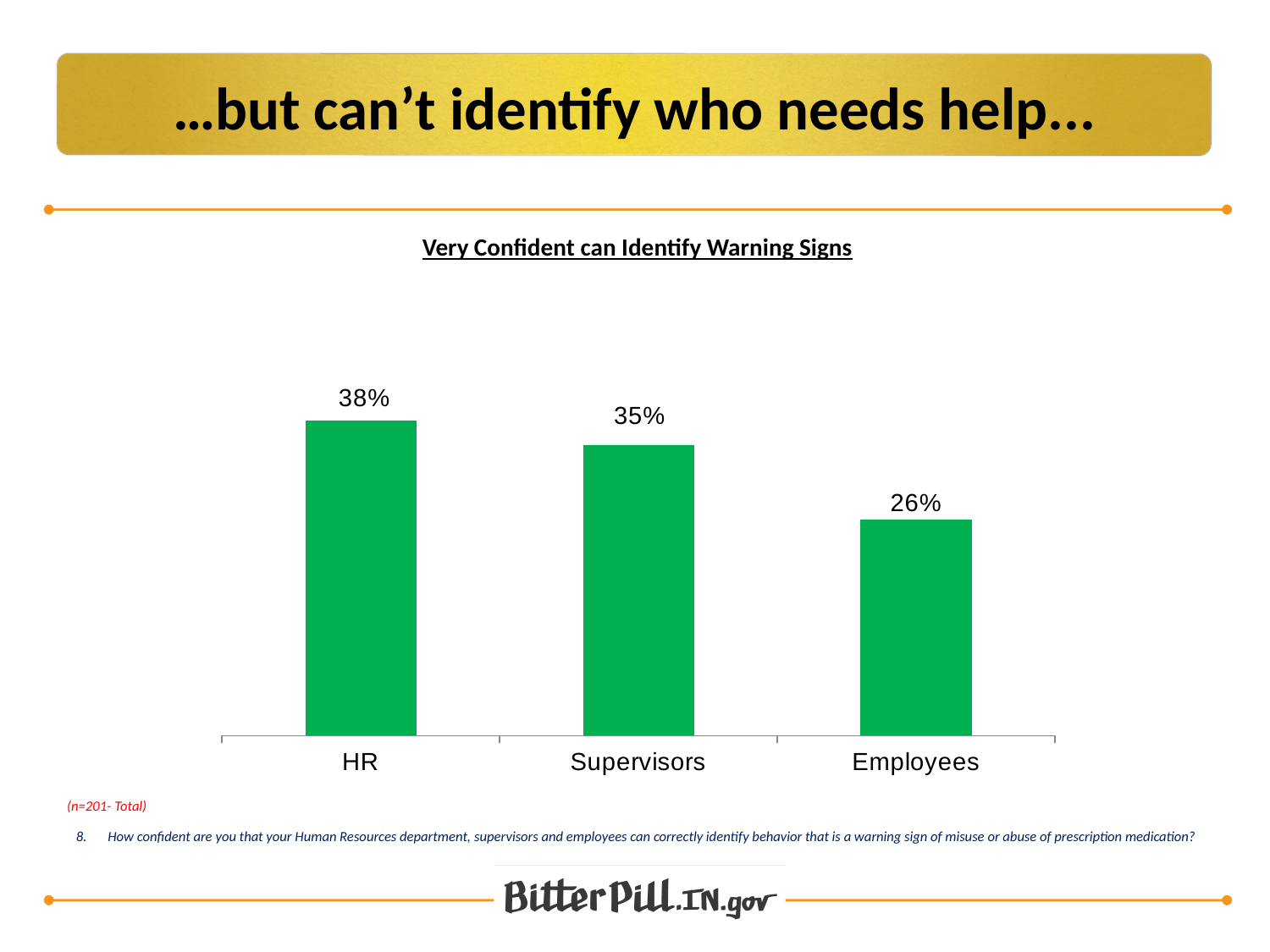
What kind of chart is shown on the slide? Bar chart What is the value for Supervisors? 35% What is the title of the chart? Very Confident can Identify Warning Signs Which category has the highest value? HR What is the difference between the values for HR and Employees? 12% How many categories are shown in the chart? 3 Which is larger, the value for HR or the value for Supervisors? HR What is the difference between the values for Supervisors and Employees? 9% Do the values rise or fall from left to right across the categories? Fall What is the value for HR? 38% Which category has the lowest value? Employees What is the value for Employees? 26%